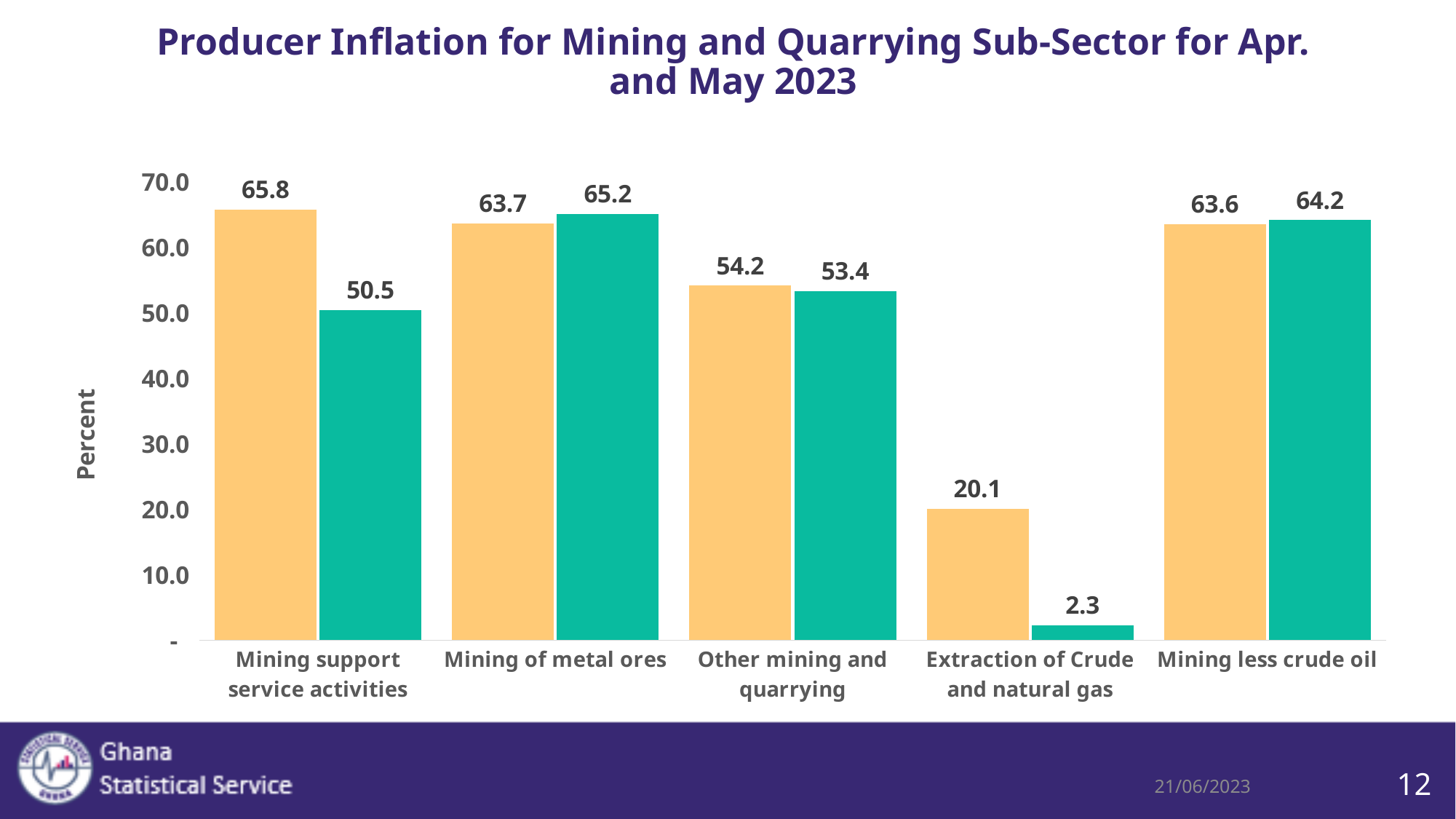
Which category has the lowest green bar? Extraction of Crude and natural gas What is the value of the yellow bar for Mining support service activities? 65.8 How many categories are shown on the x axis? 5 What is the value of the green bar for Mining of metal ores? 65.2 What is the difference between the yellow bar and the green bar for Extraction of Crude and natural gas? 17.8 Which category has the highest yellow bar? Mining support service activities What is the value of the green bar for Extraction of Crude and natural gas? 2.3 What is the difference between the yellow bar and the green bar for Mining support service activities? 15.3 What is the value of the yellow bar for Mining less crude oil? 63.6 Is the value of the green bar for Other mining and quarrying greater or less than 50.0? greater For Mining of metal ores, which bar is larger, the yellow bar or the green bar? the green bar What kind of chart is shown on the slide? bar chart